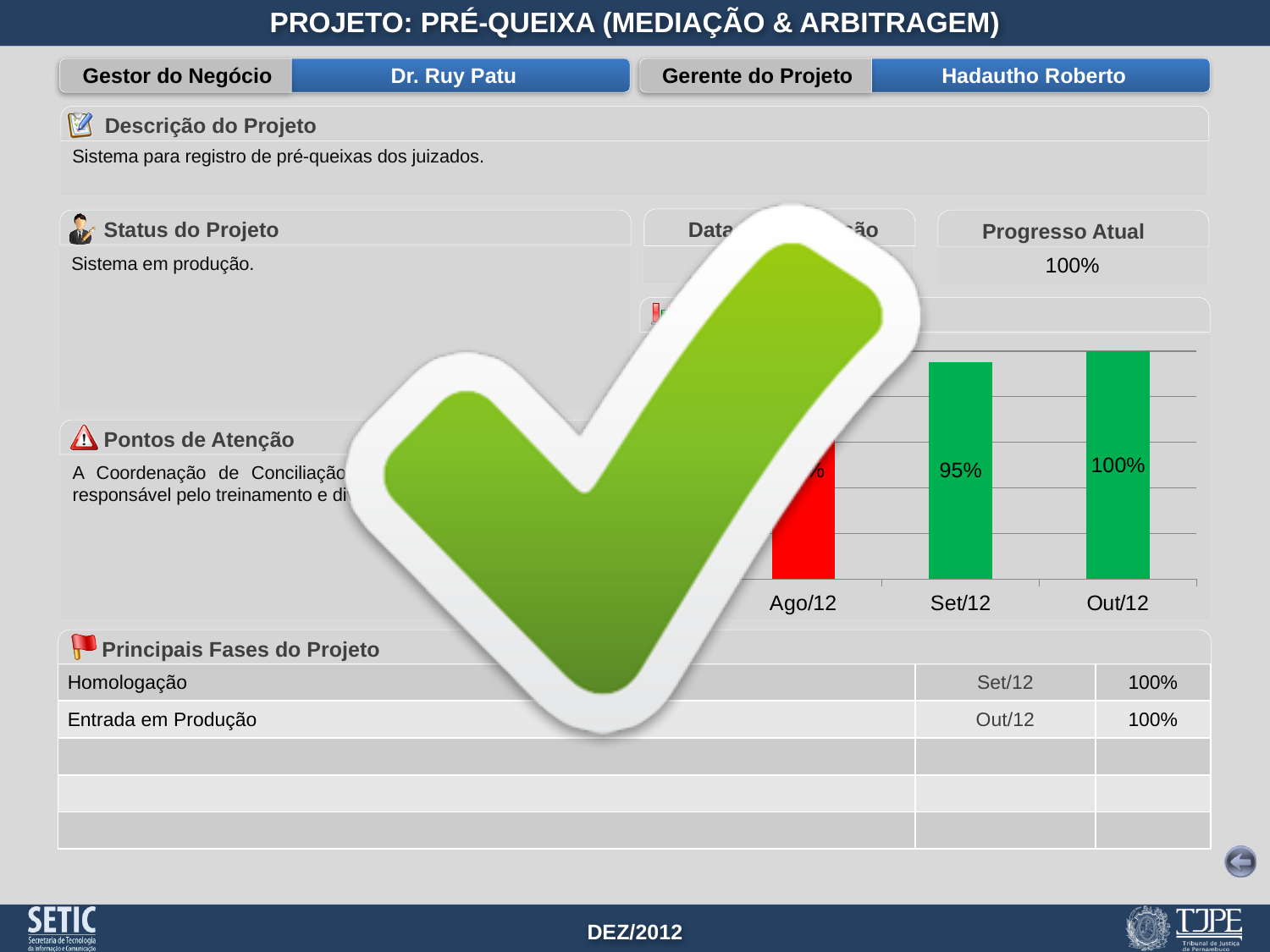
What is the difference between the values for Out/12 and Set/12 in the progress bar chart? 5% What colour is the bar for Ago/12 in the progress bar chart? Red What is the value for Out/12 in the progress bar chart? 100% What colour are the bars for Set/12 and Out/12 in the progress bar chart? Green Which month has the highest value in the progress bar chart? Out/12 Do the values in the progress bar chart rise or fall from Ago/12 to Out/12? Rise Which is larger in the progress bar chart, the value for Set/12 or the value for Out/12? Out/12 What kind of chart is used to show the monthly progress on the slide? Bar chart What is the value for Set/12 in the progress bar chart? 95%